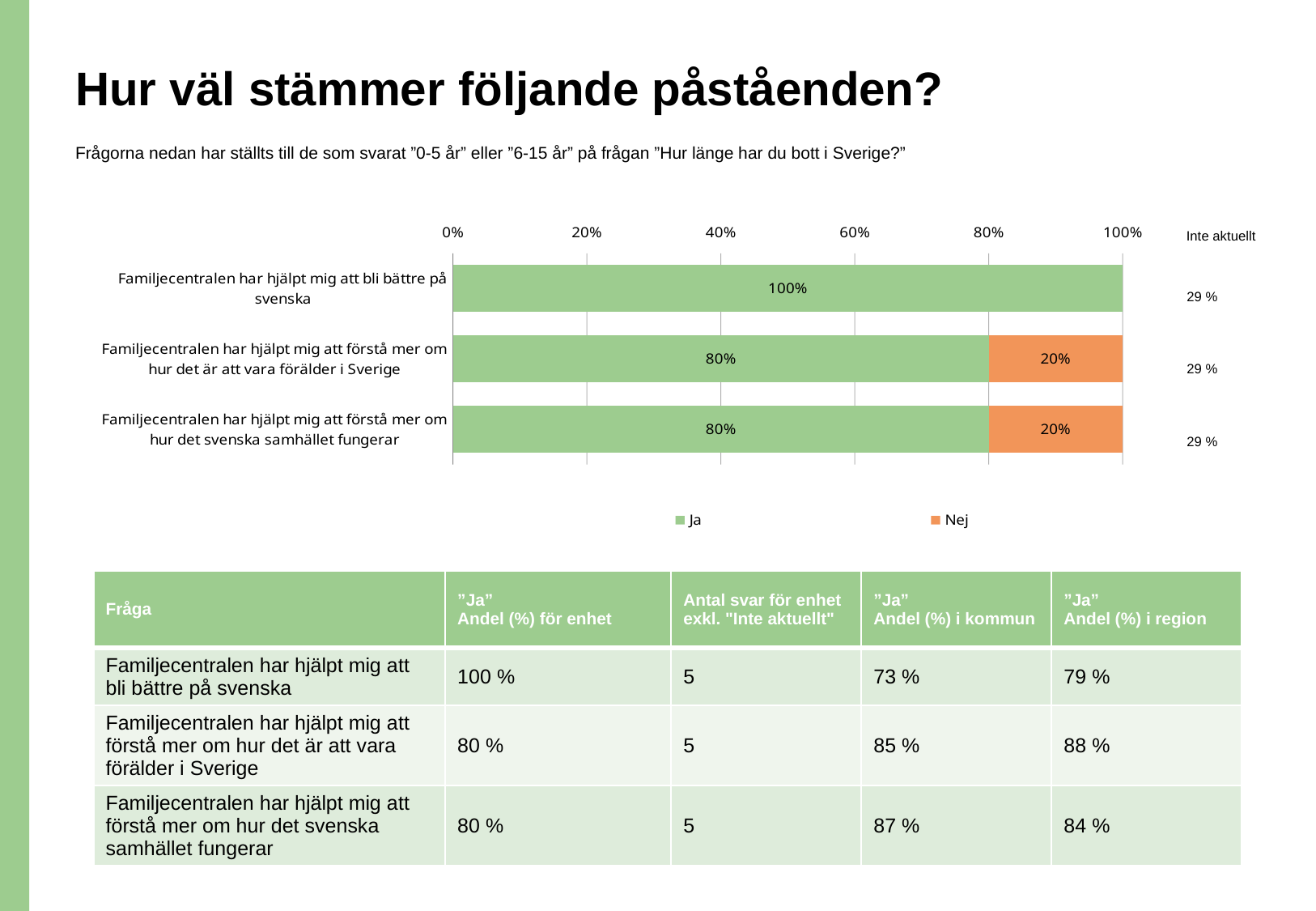
How many statements (categories) are plotted in the chart? 3 What is the difference between the "Ja" value for "Familjecentralen har hjälpt mig att bli bättre på svenska" and the "Ja" value for "Familjecentralen har hjälpt mig att förstå mer om hur det svenska samhället fungerar"? 20% Which statement has the highest "Ja" share? Familjecentralen har hjälpt mig att bli bättre på svenska What is the "Nej" value for "Familjecentralen har hjälpt mig att förstå mer om hur det är att vara förälder i Sverige"? 20% Is the "Ja" value for "Familjecentralen har hjälpt mig att förstå mer om hur det är att vara förälder i Sverige" larger or smaller than its "Nej" value? larger What is the total of the stacked bar for "Familjecentralen har hjälpt mig att förstå mer om hur det svenska samhället fungerar"? 100% What is the "Ja" value for "Familjecentralen har hjälpt mig att bli bättre på svenska"? 100% What "Inte aktuellt" value is shown next to the bar for "Familjecentralen har hjälpt mig att bli bättre på svenska"? 29 % What is the "Ja" value for "Familjecentralen har hjälpt mig att förstå mer om hur det svenska samhället fungerar"? 80% What kind of chart is shown on the slide? bar chart How many series does the chart legend list? 2 Which colour represents the "Nej" series in the chart? orange